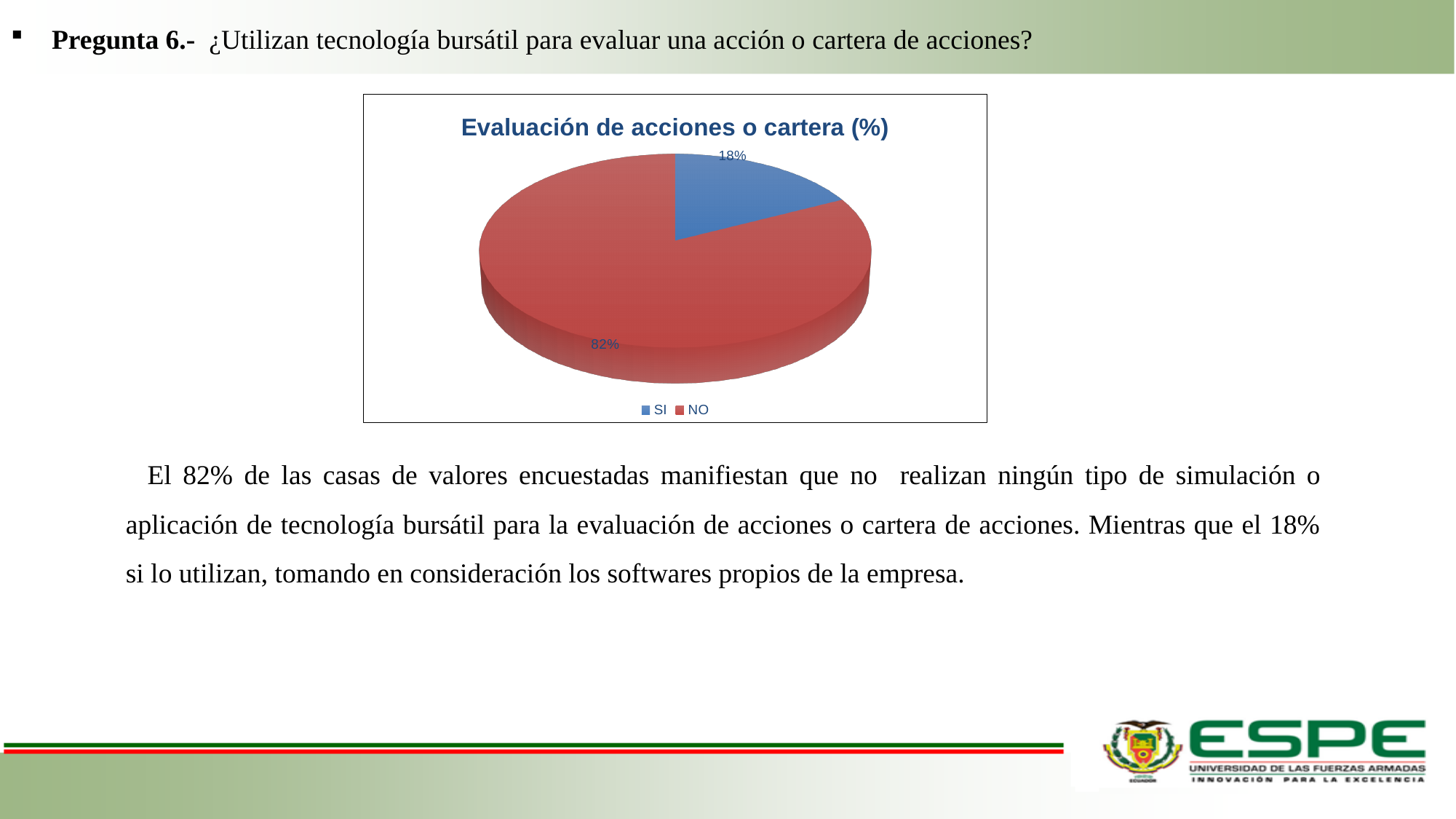
What kind of chart is shown on the slide? Pie chart How many categories does the pie chart show? 2 Which is larger, the share for SI or the share for NO? NO What is the title of the chart? Evaluación de acciones o cartera (%) What percentage of the pie corresponds to SI? 18% What share of the pie does the SI slice represent? 18% How many entries does the legend list? 2 What percentage of the pie corresponds to NO? 82% Which category has the largest share of the pie? NO What is the difference in percentage points between NO and SI? 64 Which category has the smallest share of the pie? SI What colour is the SI slice? Blue